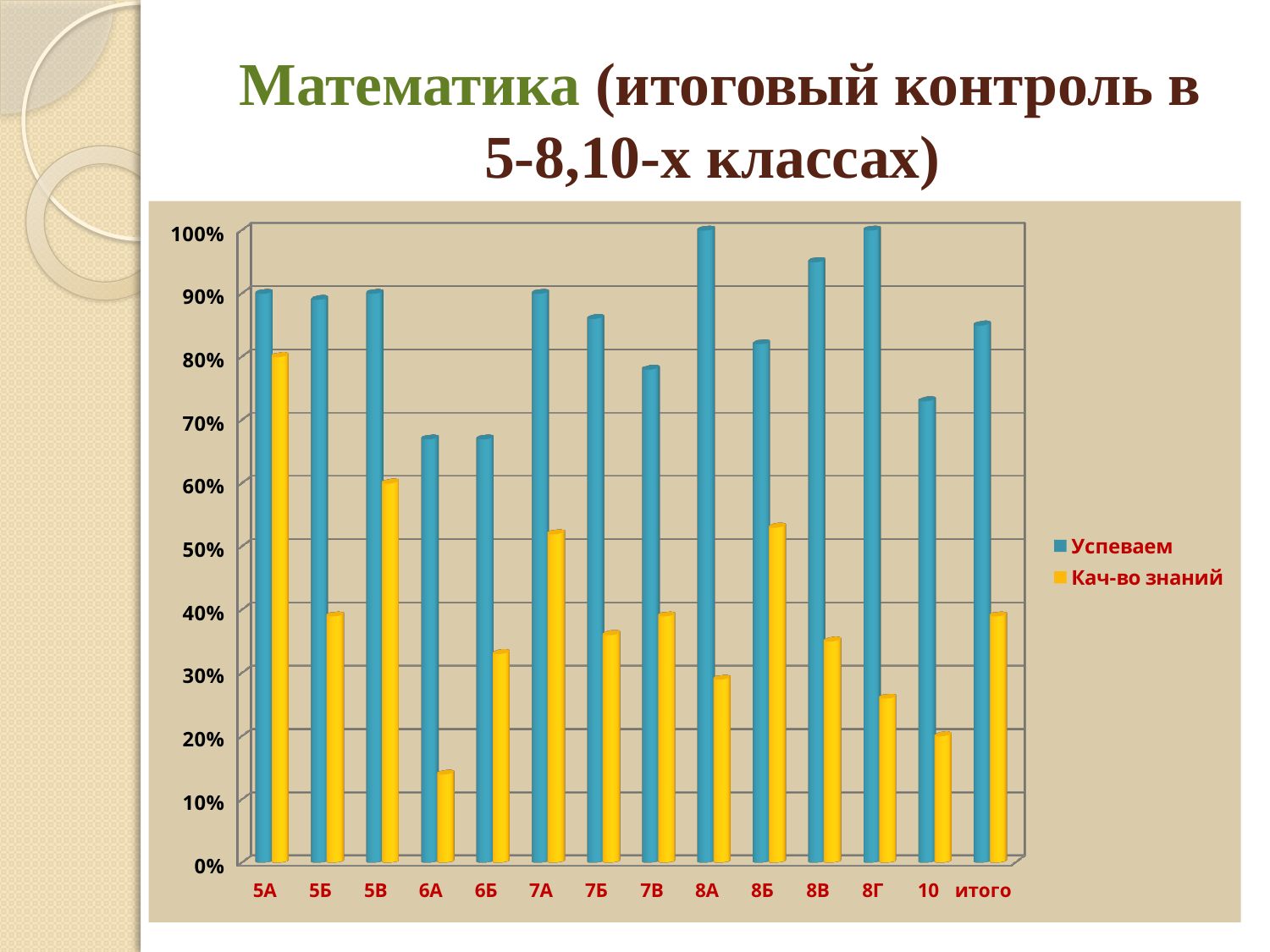
What is the Успеваем value for 8А? 100% How many categories are shown along the x axis? 14 Is the Кач-во знаний value for 8Г greater or less than 30%? less Which category has the lowest value for Кач-во знаний? 6А Is the Успеваем value for 6А greater or less than 70%? less What is the Успеваем value for 8Г? 100% What are the two series named in the legend? Успеваем and Кач-во знаний Is the Успеваем value for 8В greater or less than 90%? greater Which category has the highest value for Кач-во знаний? 5А Which is larger, the Кач-во знаний value for 5В or for 5Б? 5В How many series does the legend list? 2 What kind of chart is shown on the slide? bar chart